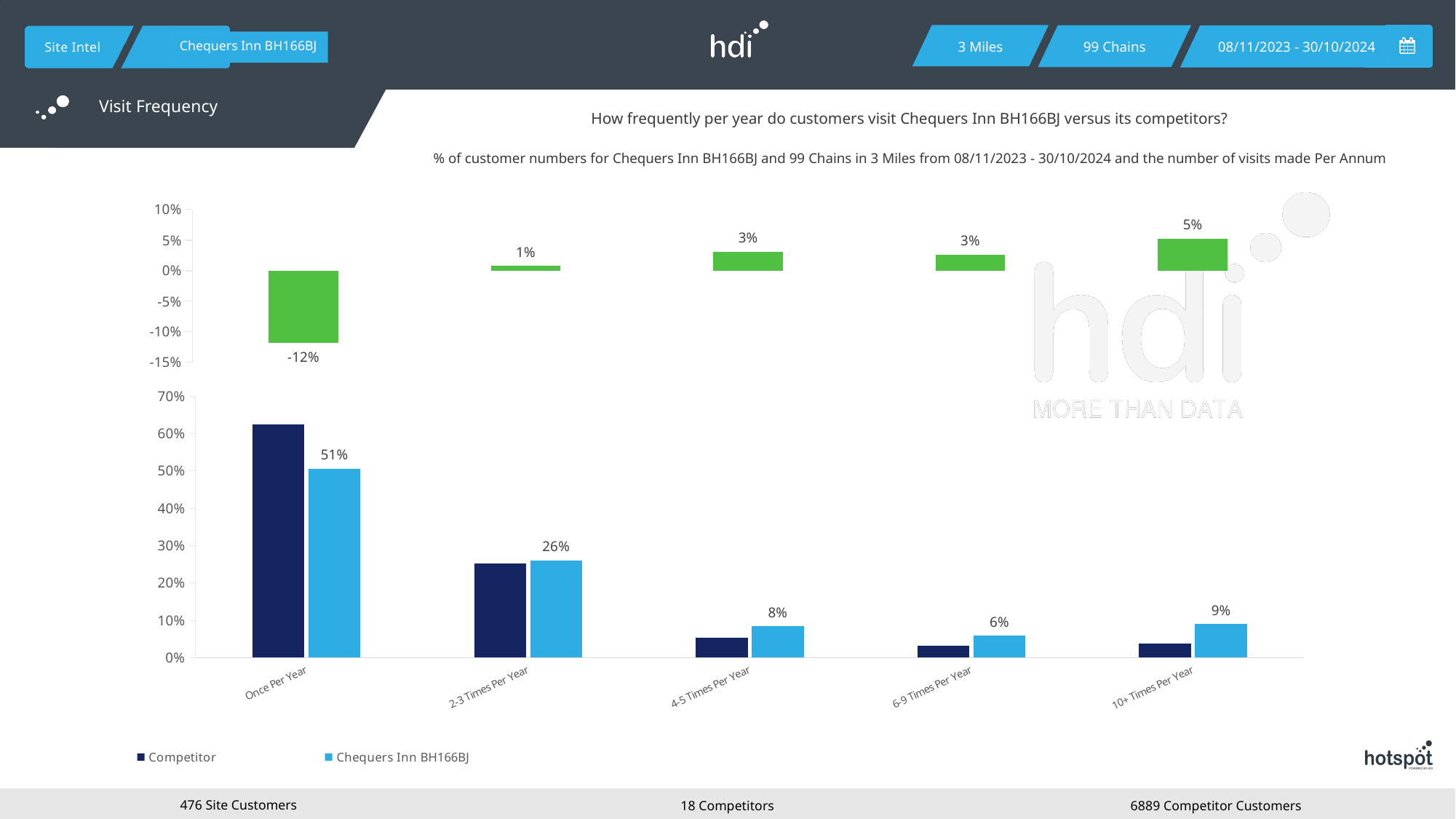
In the top chart, which category has the lowest value? Once Per Year In the bottom chart, which is larger in the 4-5 Times Per Year category: Competitor or Chequers Inn BH166BJ? Chequers Inn BH166BJ In the bottom chart, which category has the highest value for Chequers Inn BH166BJ? Once Per Year In the top chart, what is the value shown for the Once Per Year category? -12% In the bottom chart, what is the difference between the Chequers Inn BH166BJ values for Once Per Year and 2-3 Times Per Year? 25% In the bottom chart, what is the value for Chequers Inn BH166BJ in the 2-3 Times Per Year category? 26% In the bottom chart, what is the value for Chequers Inn BH166BJ in the Once Per Year category? 51% What type of chart is the bottom chart? Bar chart How many series does the legend of the bottom chart list? 2 In the top chart, what is the value shown for the 10+ Times Per Year category? 5% In the bottom chart, is the Competitor value for Once Per Year greater or less than 60%? greater In the bottom chart, what is the value for Chequers Inn BH166BJ in the 10+ Times Per Year category? 9%